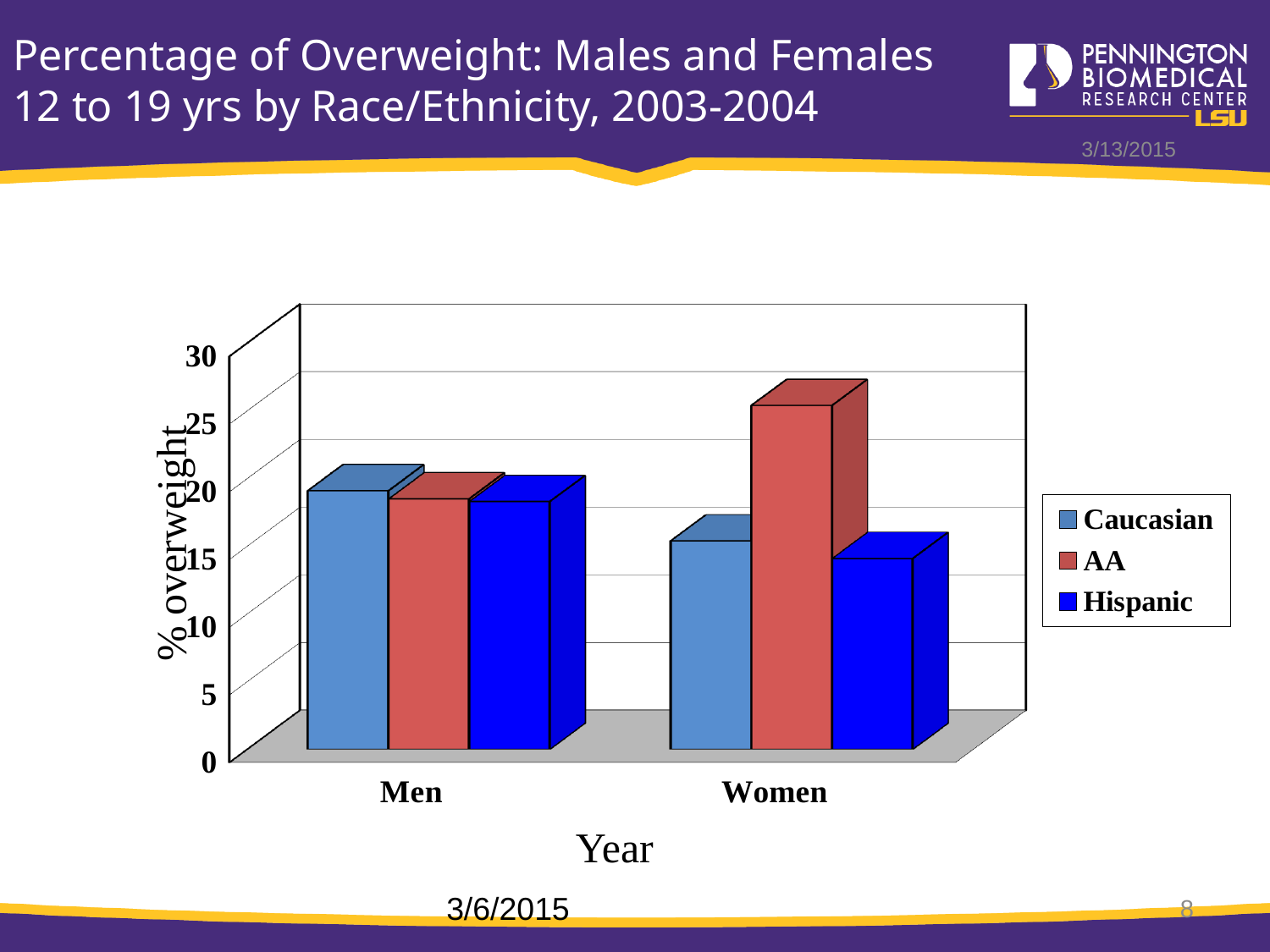
Which is larger: the Caucasian value for Men or the Caucasian value for Women? Men Which series has the lowest value for Women? Hispanic Is the value for Caucasian among Men greater or less than 15? greater How many series does the legend list? 3 Which series has the highest value for Women? AA How many categories are shown on the x axis? 2 Which is larger: the AA value for Men or the AA value for Women? Women What kind of chart is shown on the slide? bar chart Is the value for Hispanic among Women greater or less than 20? less Is the value for AA among Women greater or less than 20? greater What is the label on the vertical axis of the chart? % overweight